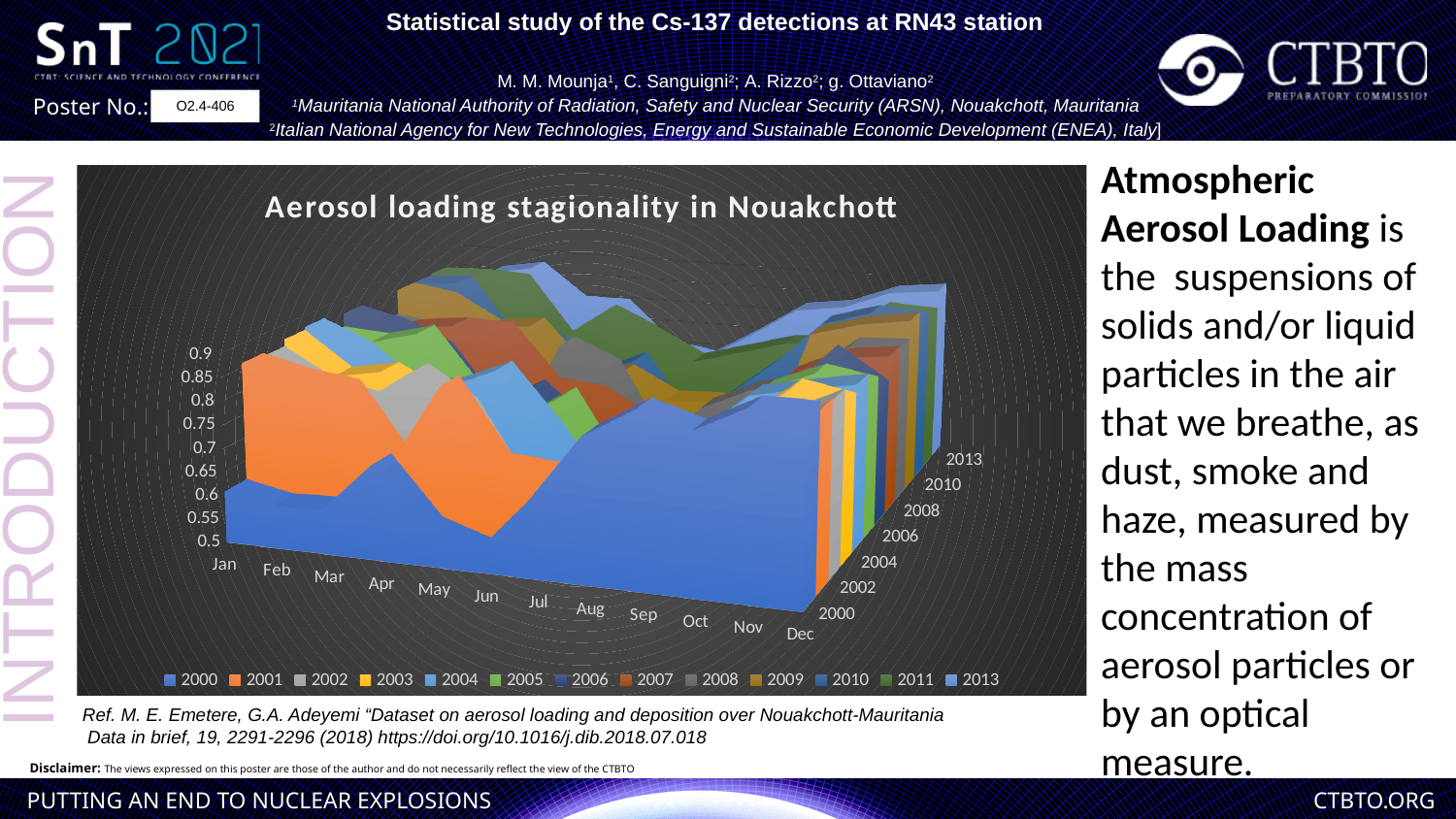
How many categories (months) are shown along the x axis of the chart? 12 Which year is the last series listed in the chart's legend? 2013 What is the last category on the x axis of the chart? Dec What kind of chart is shown on the slide? 3D area chart What is the lowest tick value shown on the vertical axis of the chart? 0.5 What is the highest tick value shown on the vertical axis of the chart? 0.9 What is the title of the chart on the slide? Aerosol loading stagionality in Nouakchott Which year is the first series listed in the chart's legend? 2000 What is the first category on the x axis of the chart? Jan Which year is missing from the legend between 2011 and 2013? 2012 How many series does the chart's legend list? 13